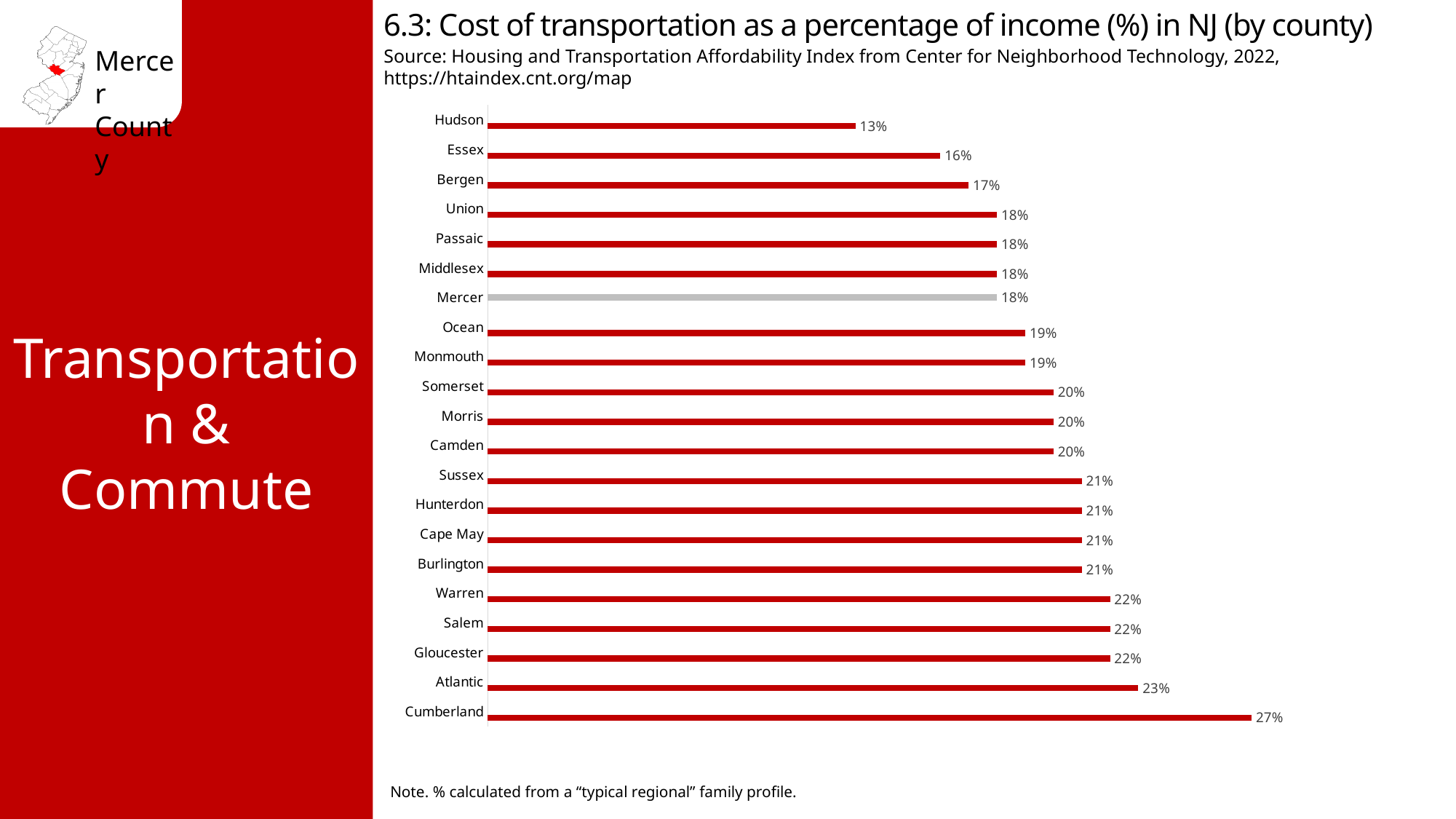
Which county has the lowest cost of transportation as a percentage of income? Hudson What is the cost of transportation as a percentage of income for Cumberland County? 27% What is the value shown for Atlantic County? 23% Which has a higher value, Essex or Somerset? Somerset What is the difference between the values for Cumberland and Hudson? 14% What is the difference between the values for Atlantic and Mercer? 5% Which county has the highest cost of transportation as a percentage of income? Cumberland What is the cost of transportation as a percentage of income for Mercer County? 18% Which county's bar is shown in grey rather than red? Mercer What type of chart is shown on the slide? Bar chart How many counties are shown in the chart? 21 What is the value shown for Hudson County? 13%